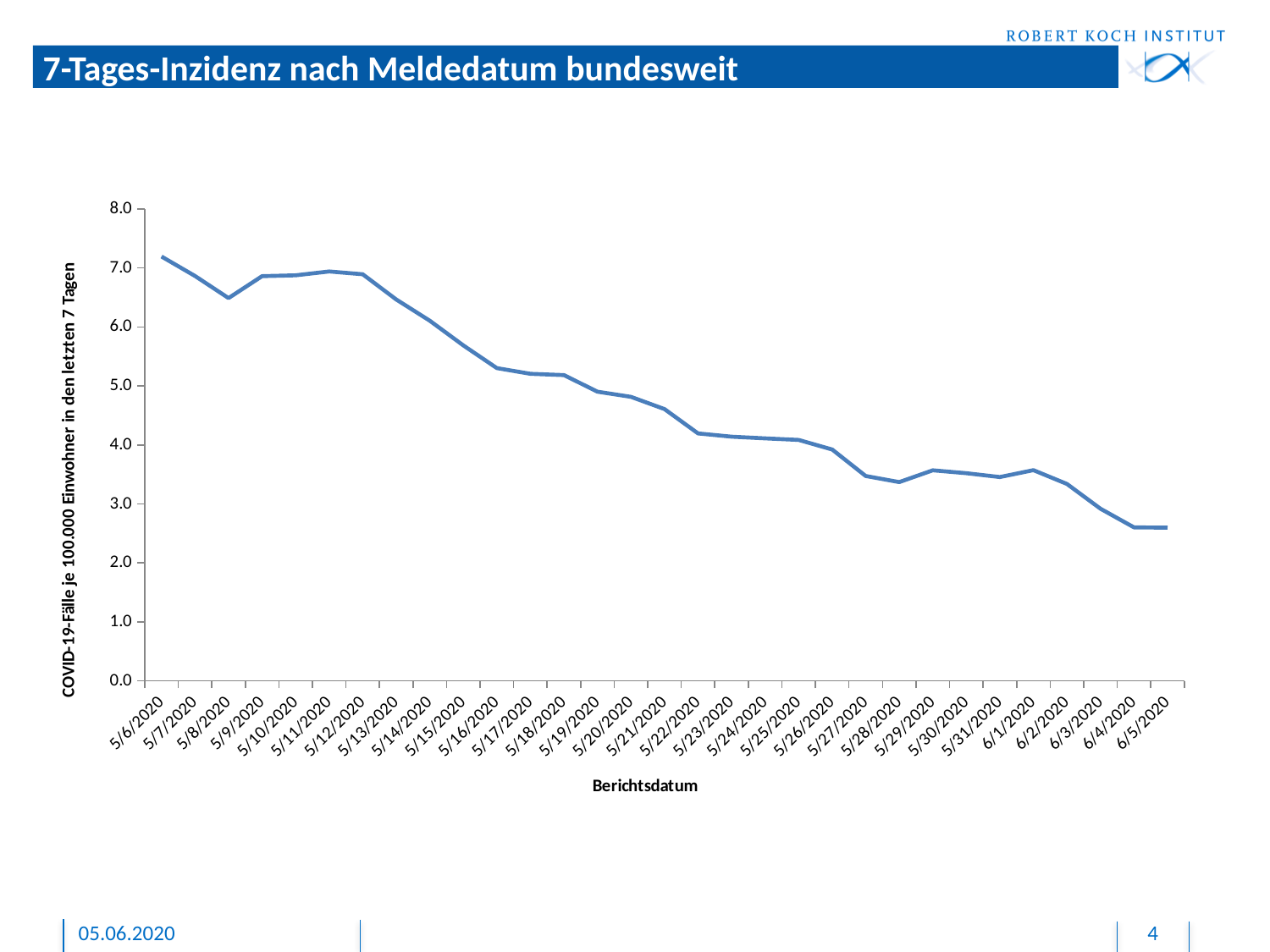
What is the label of the x axis? Berichtsdatum Is the value for 5/27/2020 greater or less than 4.0? less Do the values generally rise or fall from 5/6/2020 to 6/5/2020? fall How many dates are plotted along the x axis? 31 What kind of chart is shown on the slide? line chart Is the value for 5/16/2020 greater or less than 5.0? greater What is the title of the chart on the slide? 7-Tages-Inzidenz nach Meldedatum bundesweit Is the value for 5/6/2020 greater or less than 7.0? greater Which date has the highest value? 5/6/2020 Which is larger, the value for 5/6/2020 or the value for 6/5/2020? 5/6/2020